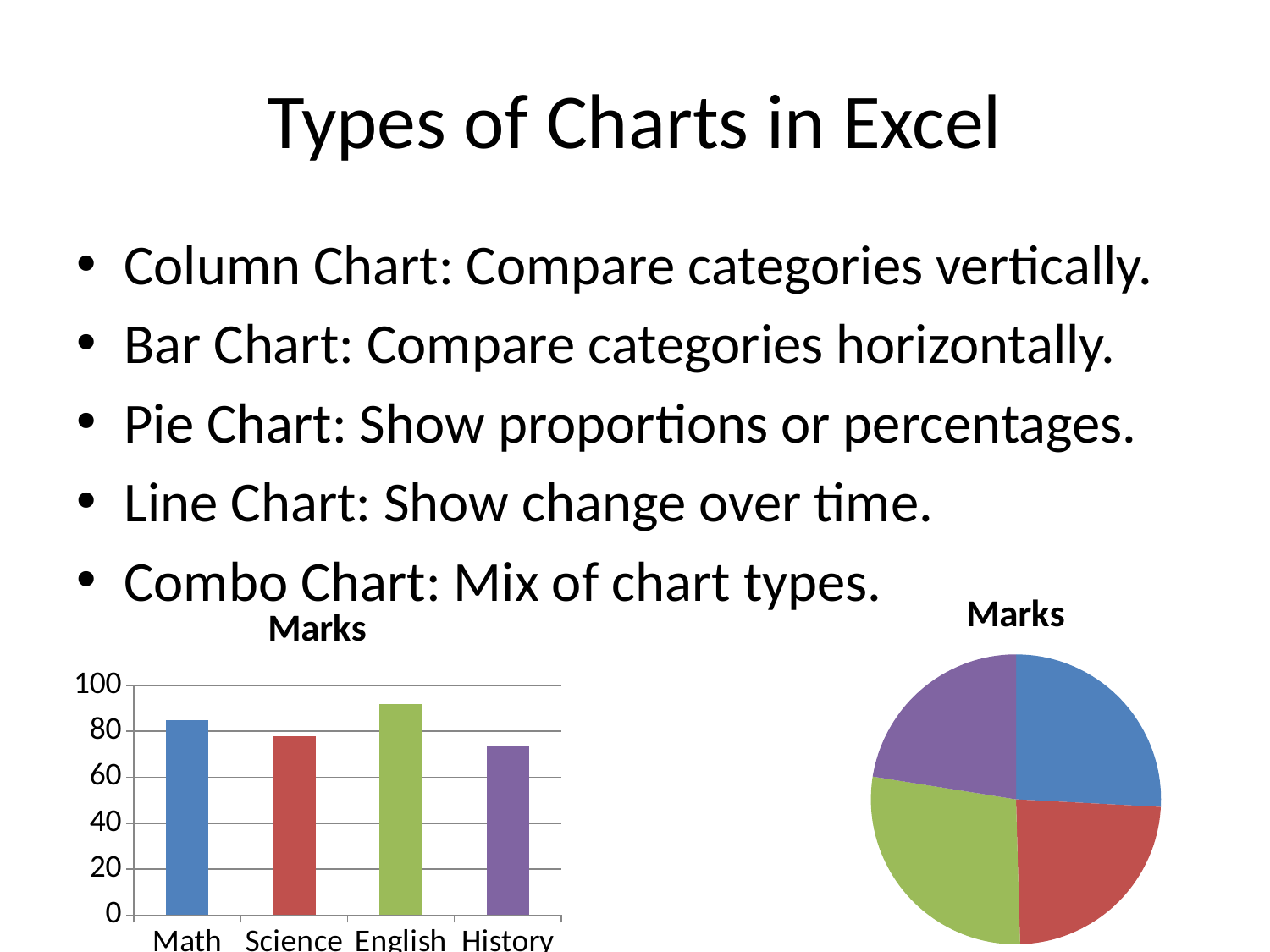
In the bar chart on the left, is the value for History greater or less than 80? less In the bar chart on the left, which is larger, the value for English or the value for History? English In the bar chart on the left, is the value for Math greater or less than 80? greater In the bar chart on the left, which category has the highest value? English In the bar chart on the left, how many categories are shown on the x axis? 4 What is the title of the bar chart on the left? Marks In the bar chart on the left, which category has the lowest value? History In the bar chart on the left, is the value for English greater or less than 80? greater In the pie chart on the right, how many slices does the pie have? 4 What kind of chart is the chart on the left of the slide? bar chart What kind of chart is the chart on the right of the slide? pie chart